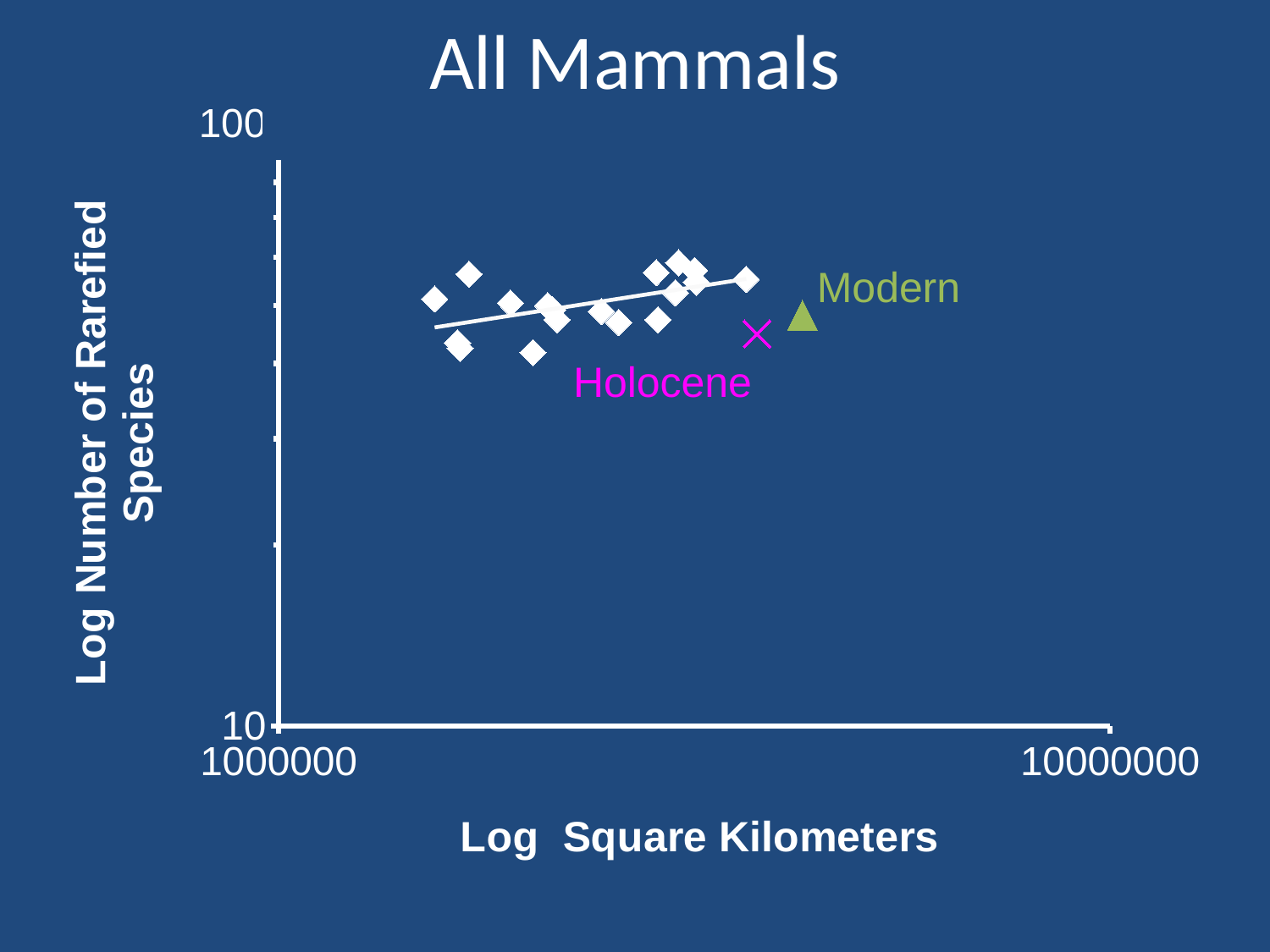
What is the lowest value shown on the y axis? 10 Which labeled point lies further to the right on the x axis, Modern or Holocene? Modern Is the square kilometers value for the Modern point greater or less than 1000000? greater Does the fitted line through the white diamond points rise or fall as the x axis increases? rise What is the highest value shown on the x axis? 10000000 What kind of chart is shown on the slide? scatter chart Which labeled point has the higher number of rarefied species, Modern or Holocene? Modern Is the square kilometers value for the Holocene point greater or less than 10000000? less Is the number of rarefied species for the Modern point greater or less than 10? greater What is the label of the x axis? Log Square Kilometers What is the title of the chart? All Mammals